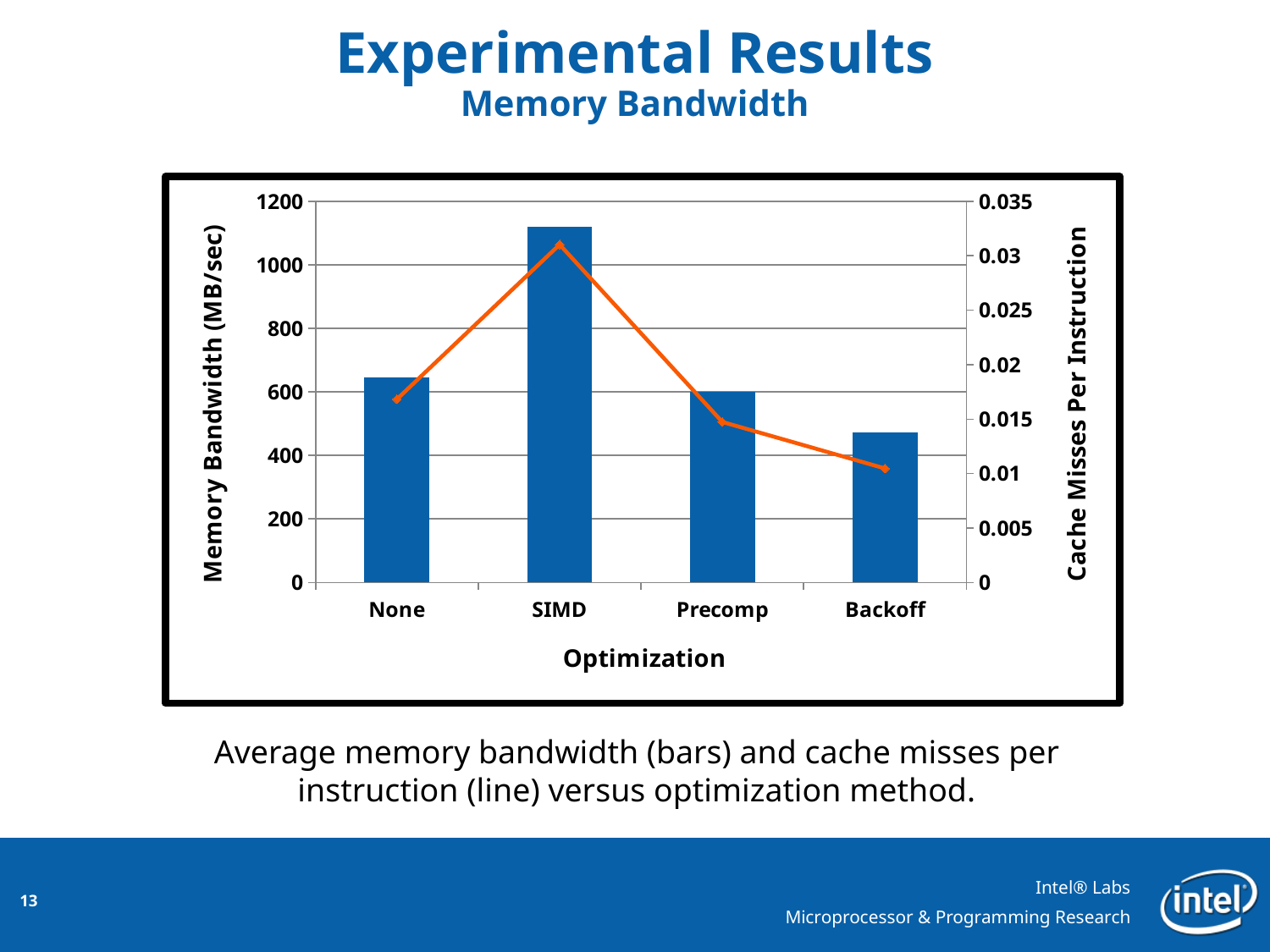
Is the cache misses per instruction value for SIMD greater or less than 0.025? greater Is the memory bandwidth bar for None greater or less than 600 MB/sec? greater What is the label of the left vertical axis? Memory Bandwidth (MB/sec) Which optimization has the highest memory bandwidth bar? SIMD Which optimization has the highest cache misses per instruction on the line? SIMD How many optimization categories are shown on the x axis? 4 Is the memory bandwidth bar for SIMD greater or less than 1000 MB/sec? greater Which optimization has the lowest memory bandwidth bar? Backoff Which has a higher memory bandwidth bar, None or Precomp? None Which optimization has the lowest cache misses per instruction on the line? Backoff